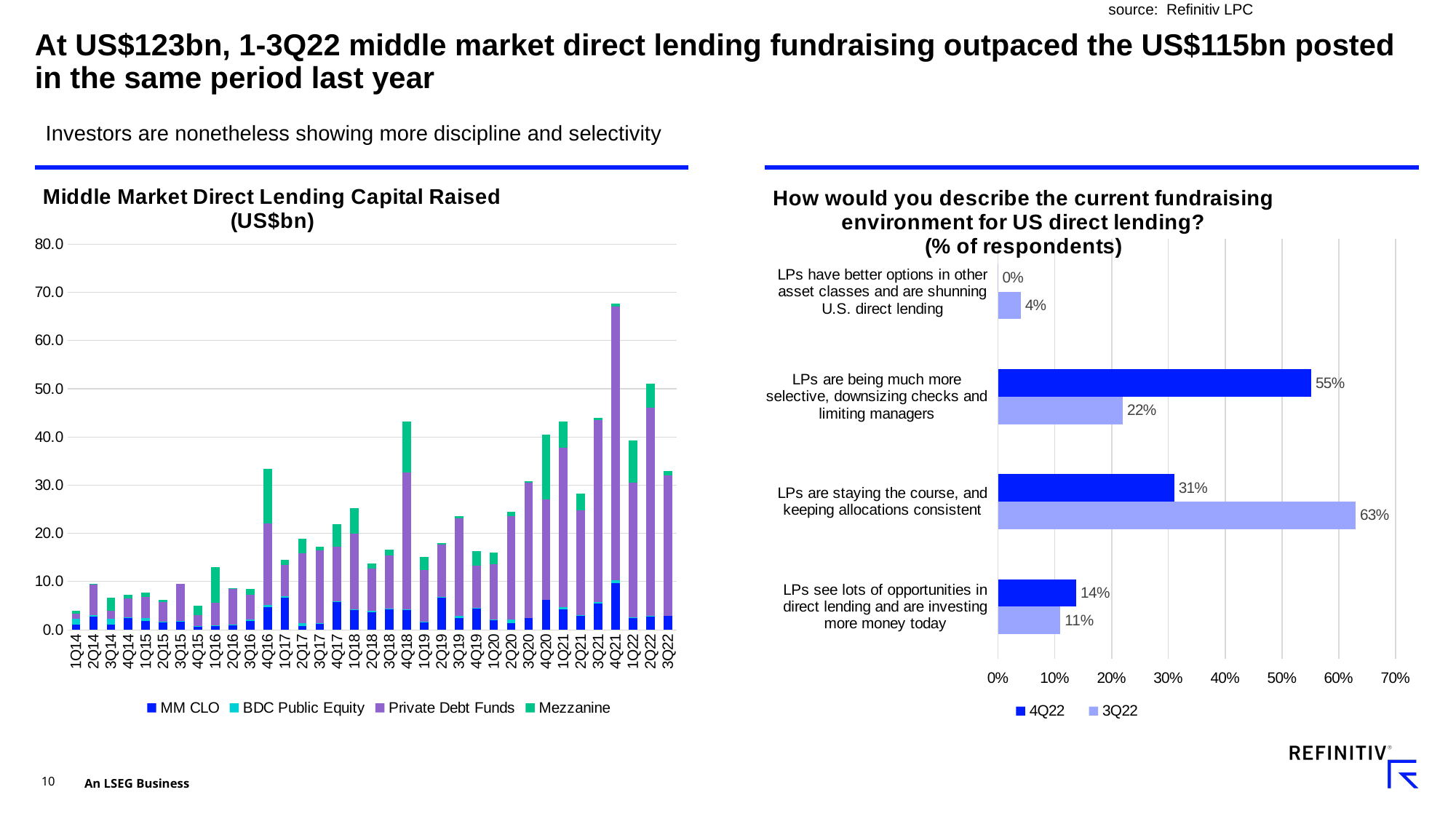
On the 'How would you describe the current fundraising environment for US direct lending?' chart, which series is larger for 'LPs see lots of opportunities in direct lending and are investing more money today', 4Q22 or 3Q22? 4Q22 On the 'How would you describe the current fundraising environment for US direct lending?' chart, what percentage of 3Q22 respondents said LPs are staying the course, and keeping allocations consistent? 63% On the 'Middle Market Direct Lending Capital Raised (US$bn)' chart, is the total for 1Q14 greater or less than 10.0? less On the 'How would you describe the current fundraising environment for US direct lending?' chart, how many response categories are shown? 4 On the 'How would you describe the current fundraising environment for US direct lending?' chart, what is the difference between the 3Q22 and 4Q22 values for 'LPs are staying the course, and keeping allocations consistent'? 32% On the 'How would you describe the current fundraising environment for US direct lending?' chart, which response has the lowest 4Q22 value? LPs have better options in other asset classes and are shunning U.S. direct lending On the 'How would you describe the current fundraising environment for US direct lending?' chart, what percentage of 4Q22 respondents said LPs are being much more selective, downsizing checks and limiting managers? 55% On the 'Middle Market Direct Lending Capital Raised (US$bn)' chart, which quarter has the highest total capital raised? 4Q21 On the 'Middle Market Direct Lending Capital Raised (US$bn)' chart, which quarter has the larger total, 2Q22 or 3Q22? 2Q22 On the 'Middle Market Direct Lending Capital Raised (US$bn)' chart, is the total for 4Q21 greater or less than 60.0? greater On the 'Middle Market Direct Lending Capital Raised (US$bn)' chart, how many series does the legend list? 4 On the 'Middle Market Direct Lending Capital Raised (US$bn)' chart, what kind of chart is shown? Stacked bar chart